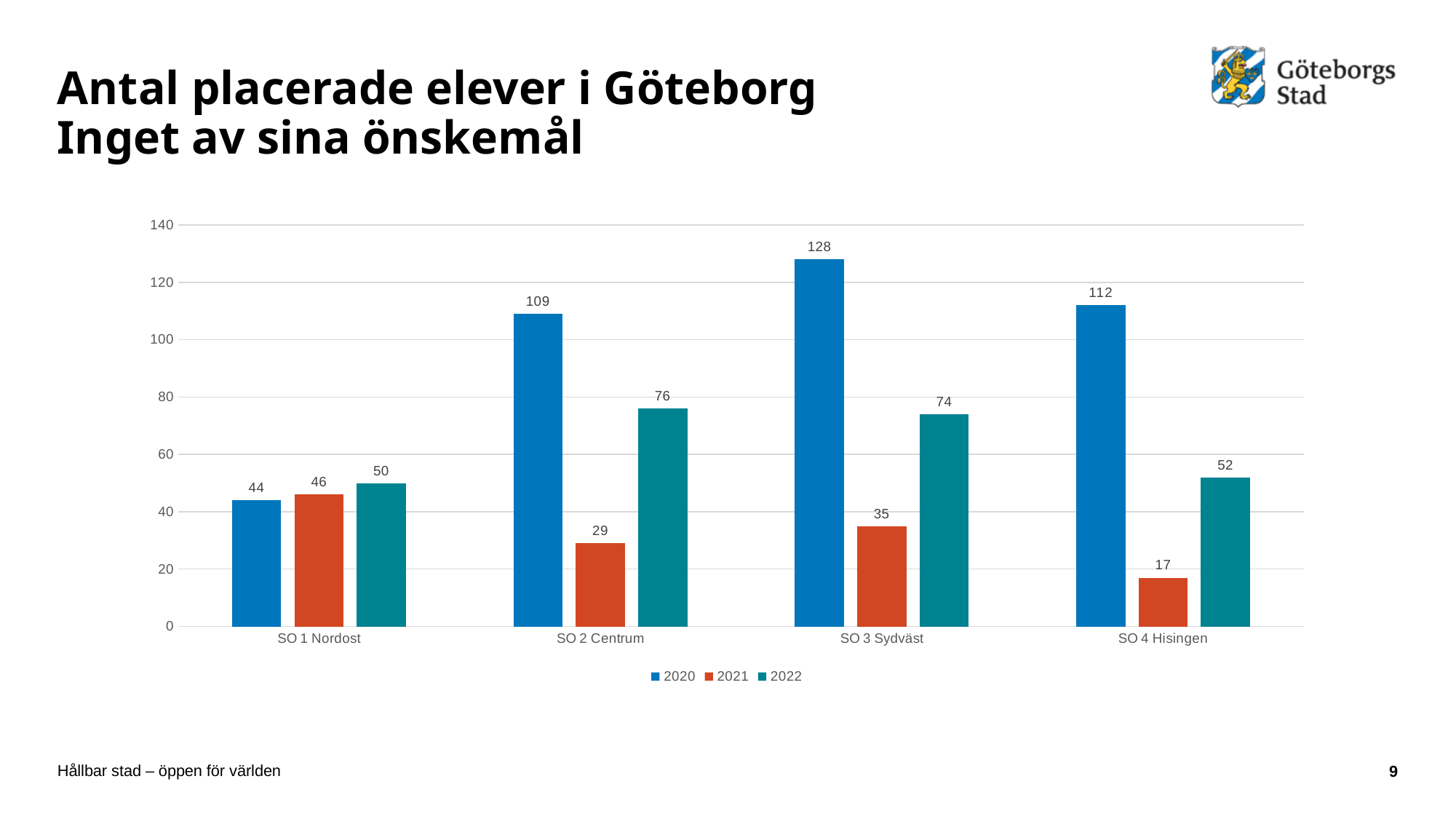
What kind of chart is shown on the slide? bar chart Which is larger for SO 1 Nordost: the 2021 value or the 2022 value? 2022 What is the value for SO 2 Centrum in 2020? 109 How many categories are shown on the x axis? 4 Is the value for SO 4 Hisingen in 2020 greater or less than 100? greater What is the difference between the 2020 and 2022 values for SO 2 Centrum? 33 Which category has the highest value in the 2020 series? SO 3 Sydväst Which category has the lowest value in the 2021 series? SO 4 Hisingen Do the values for SO 1 Nordost rise or fall from 2020 to 2022? rise What is the value for SO 3 Sydväst in 2022? 74 What is the value for SO 4 Hisingen in 2021? 17 How many series does the legend list? 3